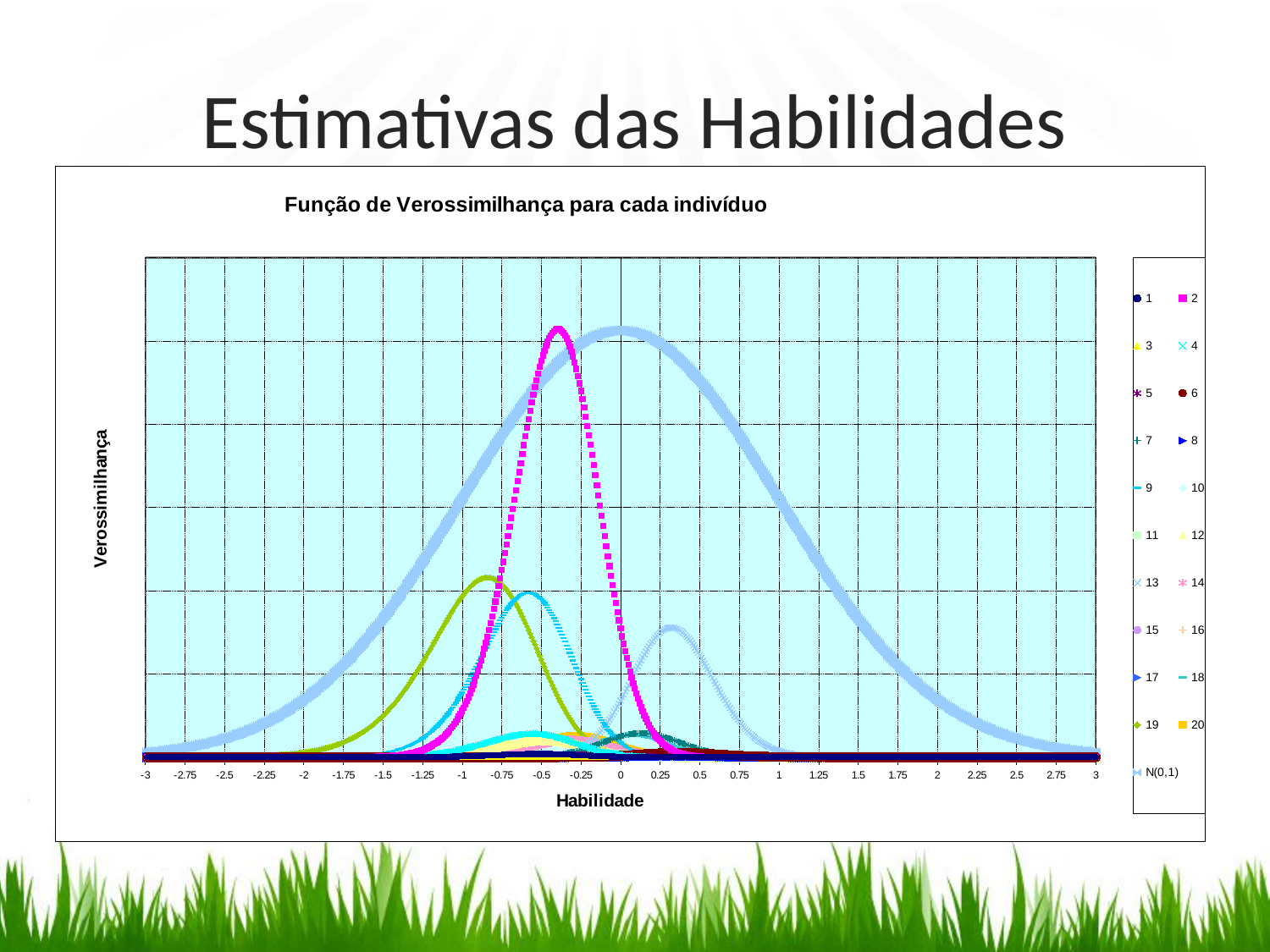
What is the lowest value shown on the x axis? -3 What is the label of the x axis? Habilidade What is the title of the chart? Função de Verossimilhança para cada indivíduo What kind of chart is shown on the slide? line chart How many series does the chart legend list? 21 What is the highest value shown on the x axis? 3 Does the N(0,1) curve rise or fall as Habilidade goes from 0 to 3? fall At Habilidade = 2, which is higher: the N(0,1) curve or series 2? N(0,1) How many tick labels are shown along the x axis? 25 Which series has the widest curve across the Habilidade axis? N(0,1) Does series 2 peak to the left or to the right of Habilidade = 0? left Does the N(0,1) curve rise or fall as Habilidade goes from -3 to 0? rise